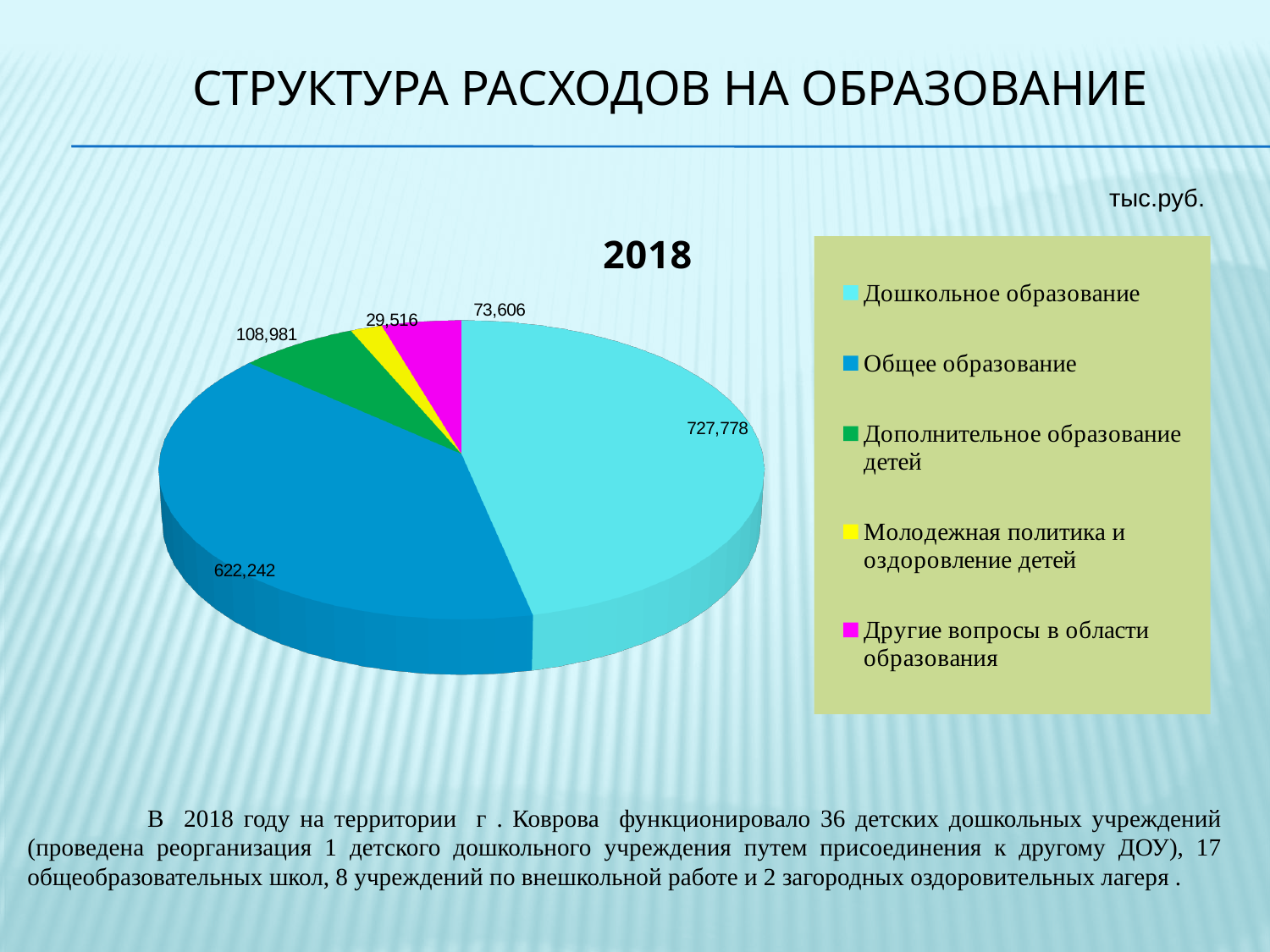
Which is larger: Дополнительное образование детей or Другие вопросы в области образования? Дополнительное образование детей What is the value for Молодежная политика и оздоровление детей in the 2018 pie chart? 29,516 What is the value for Дошкольное образование in the 2018 pie chart? 727,778 Which category has the largest slice in the 2018 pie chart? Дошкольное образование What kind of chart is shown on the slide? Pie chart What unit is indicated for the values in the chart? тыс.руб. What is the difference between the values for Дошкольное образование and Общее образование? 105,536 How many slices does the pie chart have? 5 What is the value for Другие вопросы в области образования in the 2018 pie chart? 73,606 Which category has the smallest slice in the 2018 pie chart? Молодежная политика и оздоровление детей What is the value for Общее образование in the 2018 pie chart? 622,242 What is the value for Дополнительное образование детей in the 2018 pie chart? 108,981